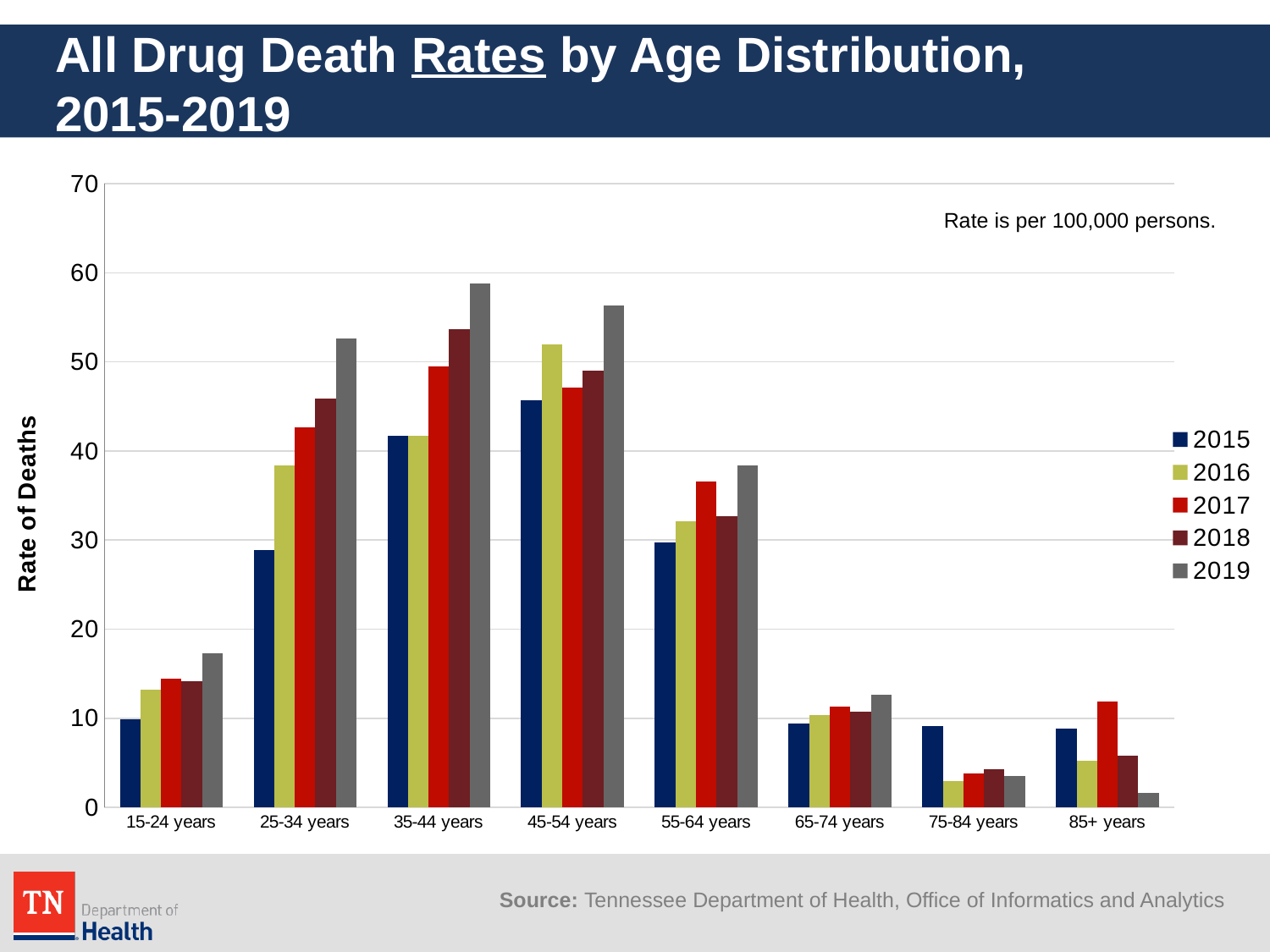
For 45-54 years, which year has the larger value, 2016 or 2017? 2016 What kind of chart is shown on the slide? bar chart For 25-34 years, which year has the larger value, 2015 or 2019? 2019 For the 25-34 years group, do the values rise or fall from 2015 to 2019? rise How many series does the legend list? 5 Is the 2015 value for 25-34 years greater or less than 30? less Which age group has the lowest 2019 death rate? 85+ years Is the 2017 value for 85+ years greater or less than 10? greater Is the 2019 value for 35-44 years greater or less than 50? greater Which age group has the highest 2019 death rate? 35-44 years What is the title of the y axis? Rate of Deaths How many age groups are shown on the x axis? 8